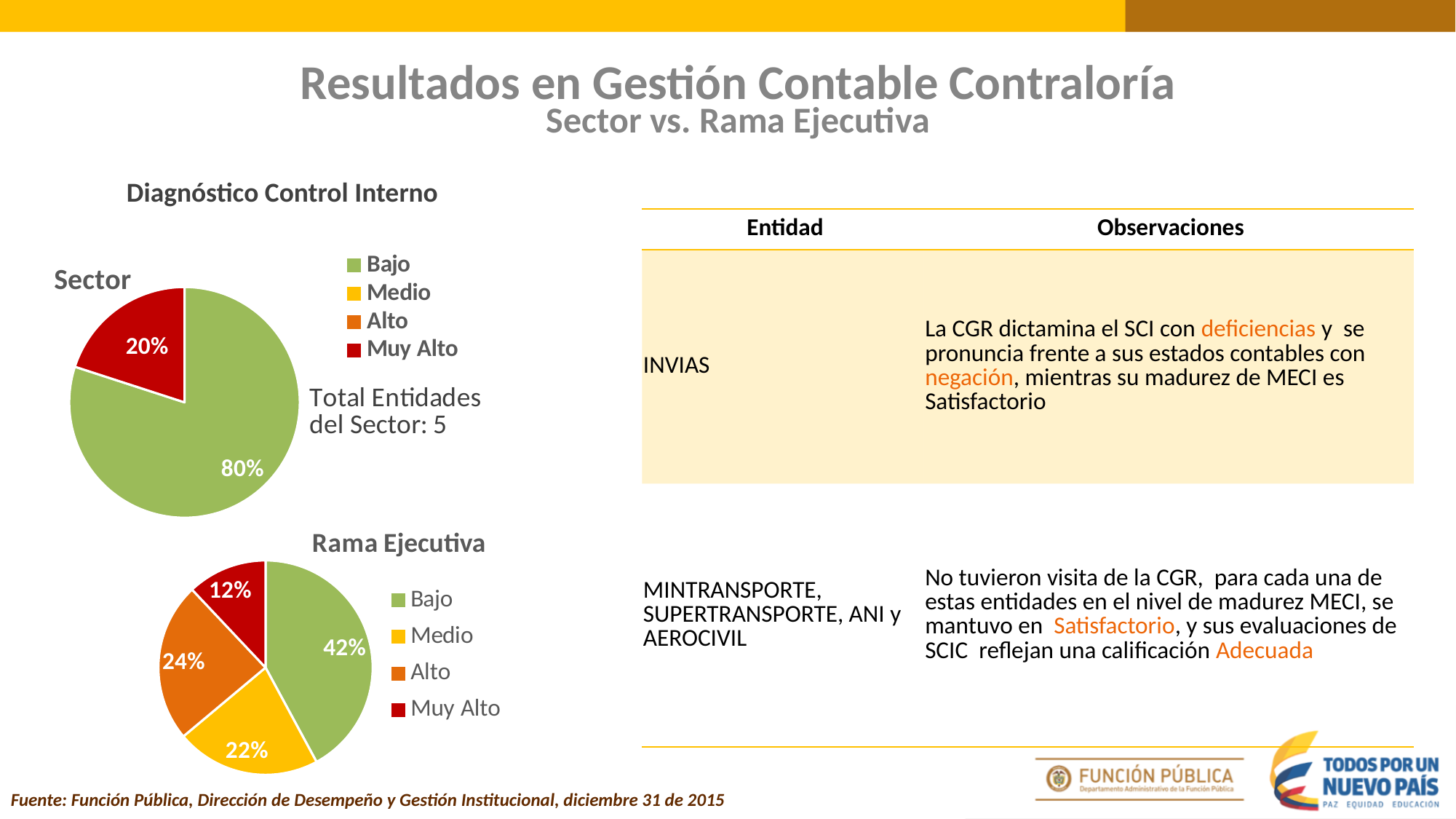
In the Rama Ejecutiva pie chart, what share is Medio? 22% In the Rama Ejecutiva pie chart, what share is Bajo? 42% What type of chart is the Sector chart? Pie chart In the Rama Ejecutiva pie chart, which category has the largest share? Bajo In the Rama Ejecutiva pie chart, what is the difference between the Bajo and Muy Alto shares? 30% In the Rama Ejecutiva pie chart, which is larger, Alto or Medio? Alto In the Rama Ejecutiva pie chart, what share is Alto? 24% In the Sector pie chart, what share is Bajo? 80% In the Sector pie chart, what share is Muy Alto? 20% In the Rama Ejecutiva pie chart, which category has the smallest share? Muy Alto How many slices with data labels does the Sector pie chart have? 2 How many entries does the legend of the Rama Ejecutiva pie chart list? 4